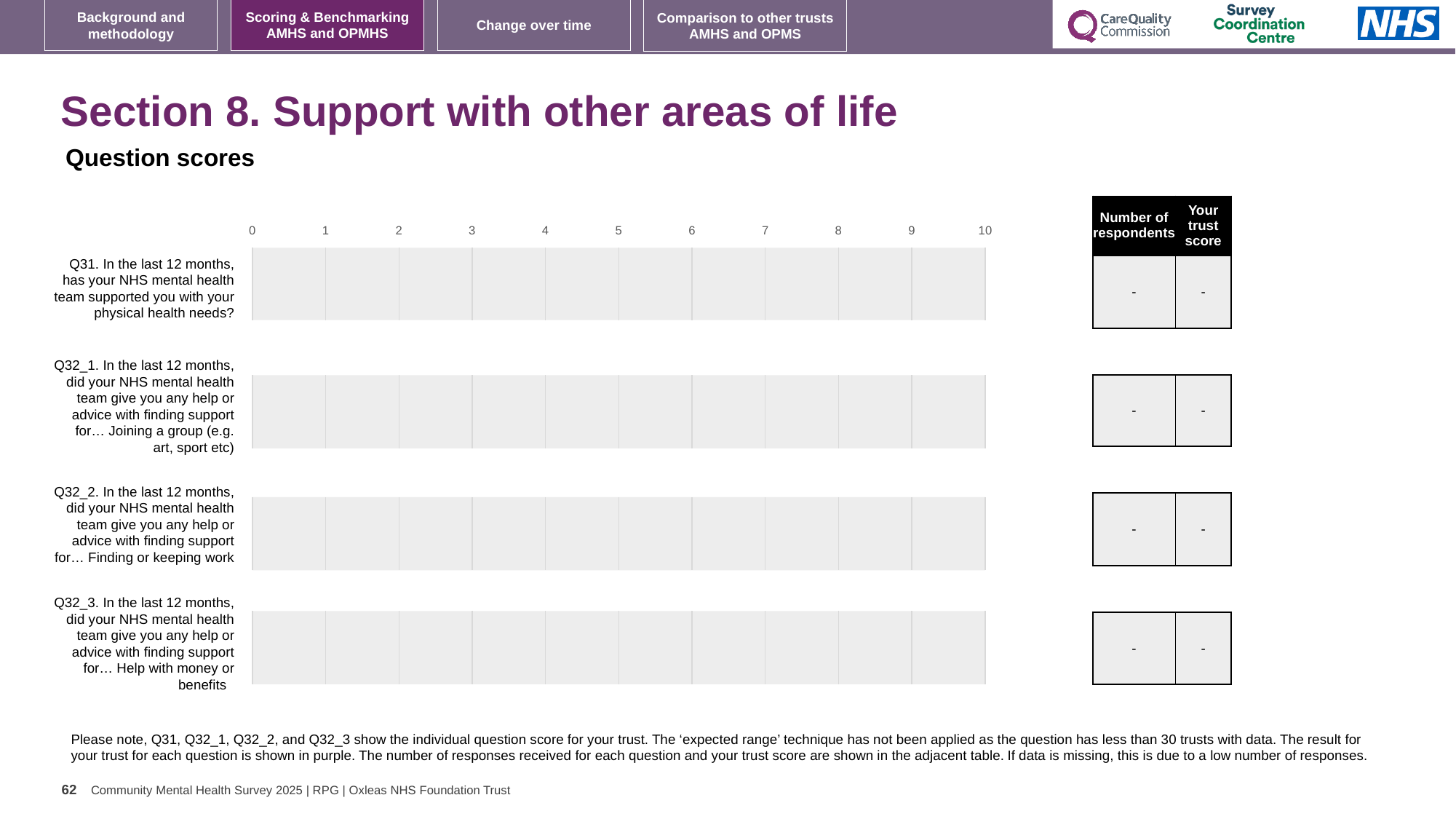
What is the number of respondents shown for Q32_3 in the adjacent table? - What is the number of respondents shown for Q31 in the adjacent table? - What is the trust score shown for Q32_2 in the adjacent table? - Which question label on the chart refers to physical health needs? Q31 Which question label on the chart refers to help with money or benefits? Q32_3 What is the trust score shown for Q32_1 in the adjacent table? - What is the lowest value shown on the chart's axis? 0 How many questions (categories) are listed on the chart? 4 What is the highest value shown on the chart's axis? 10 What kind of chart is used for the question scores? bar chart